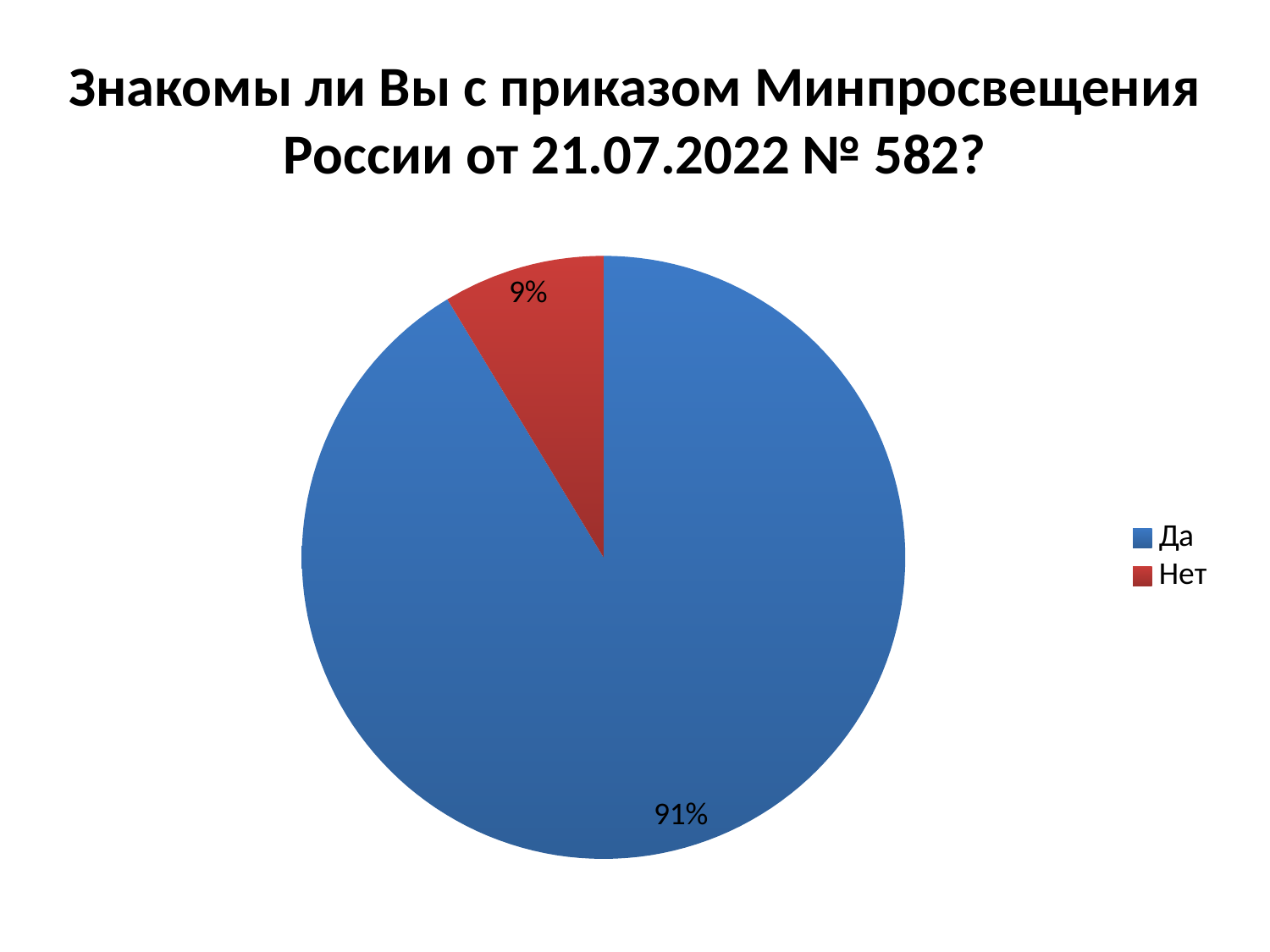
What is the difference in percentage points between the "Да" and "Нет" slices? 82 Which category has the largest slice of the pie? Да Which category has the smallest slice of the pie? Нет How many categories are shown in the pie chart? 2 What share of the pie does "Нет" represent? 9% What share of the pie does "Да" represent? 91% What colour is the "Нет" slice? red What is the title of the chart? Знакомы ли Вы с приказом Минпросвещения России от 21.07.2022 № 582? Which slice is larger, "Да" or "Нет"? Да How many entries does the legend list? 2 What kind of chart is shown on the slide? pie chart